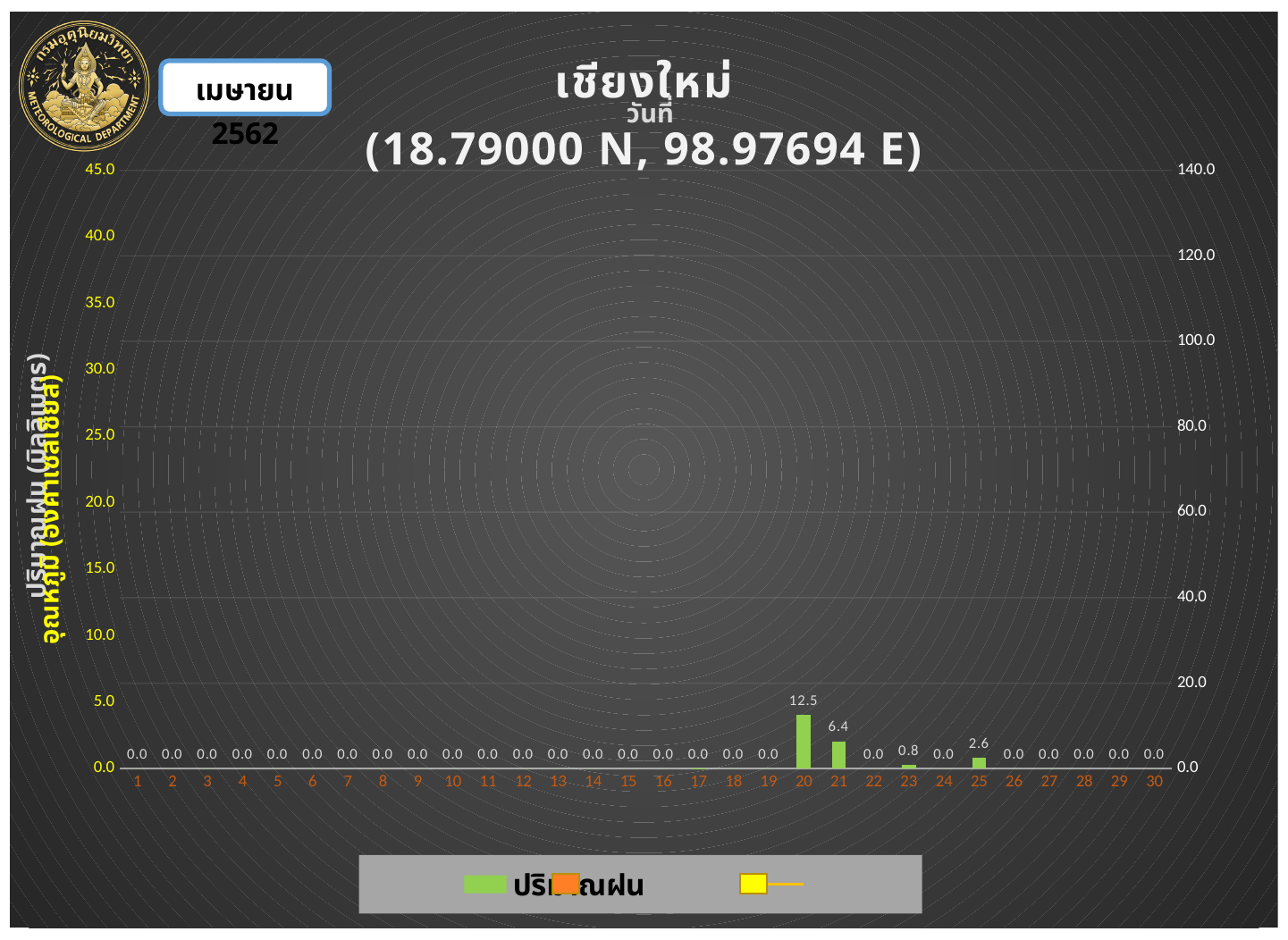
What is the rainfall value shown for day 20? 12.5 What is the rainfall value shown for day 10? 0.0 Which day has the larger rainfall value, day 21 or day 25? 21 What kind of chart is shown on the slide? bar chart How many days are shown on the x axis? 30 What is the rainfall value shown for day 25? 2.6 Which day has the highest rainfall value? 20 What is the rainfall value shown for day 23? 0.8 What is the difference between the rainfall values for day 20 and day 21? 6.1 What is the rainfall value shown for day 21? 6.4 What is the difference between the rainfall values for day 25 and day 23? 1.8